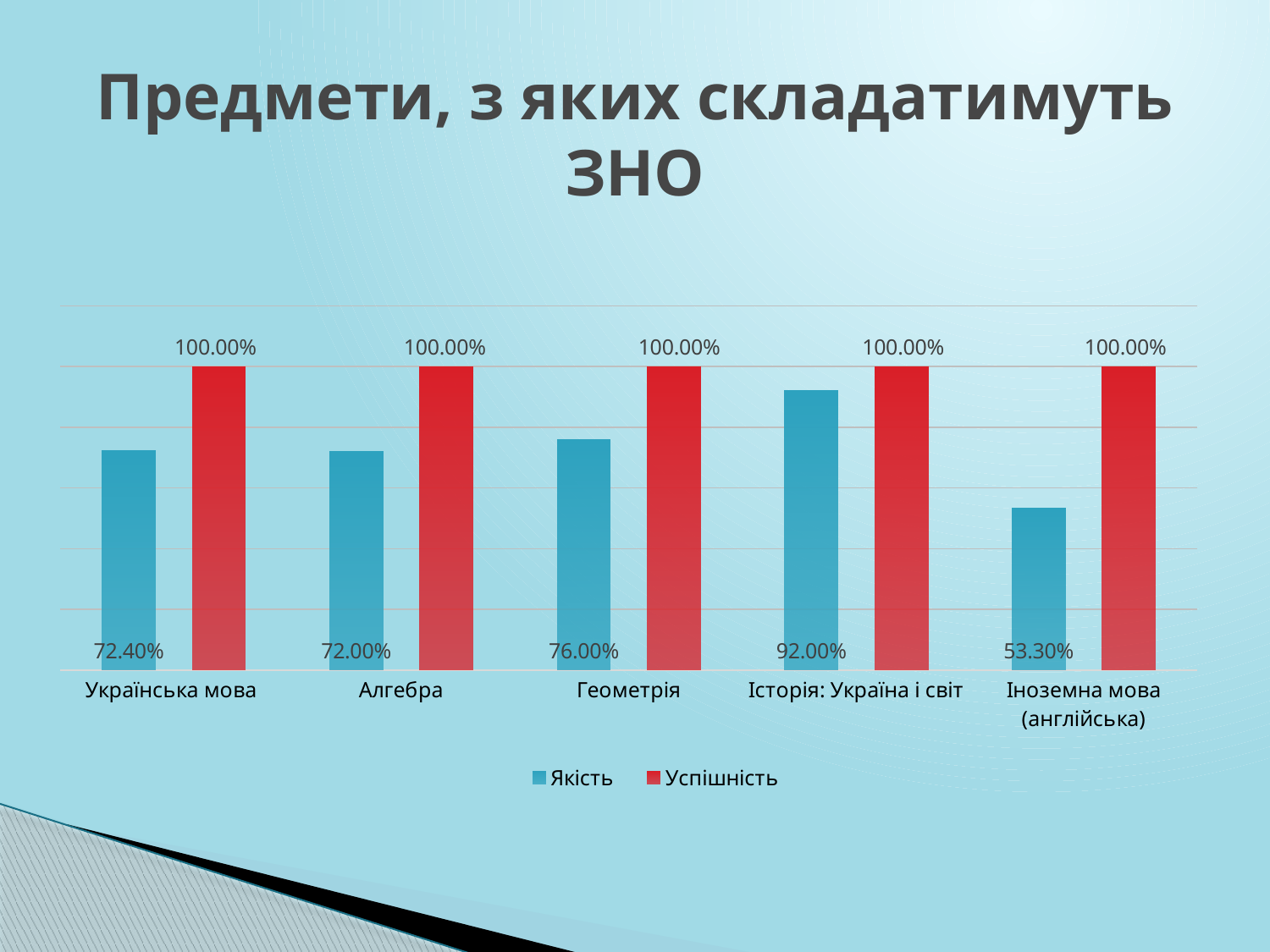
How many subjects are shown on the chart? 5 What is the title of the chart on the slide? Предмети, з яких складатимуть ЗНО Which subject has the lowest Якість value? Іноземна мова (англійська) Which colour represents the Успішність series? Red What is the Успішність value for Алгебра? 100.00% Which subject has the highest Якість value? Історія: Україна і світ What is the difference between the Якість values for Історія: Україна і світ and Іноземна мова (англійська)? 38.70% What is the Якість value for Іноземна мова (англійська)? 53.30% Which is larger, the Якість value for Українська мова or for Геометрія? Геометрія What kind of chart is shown on the slide? Bar chart How many series does the legend list? 2 What is the Якість value for Геометрія? 76.00%